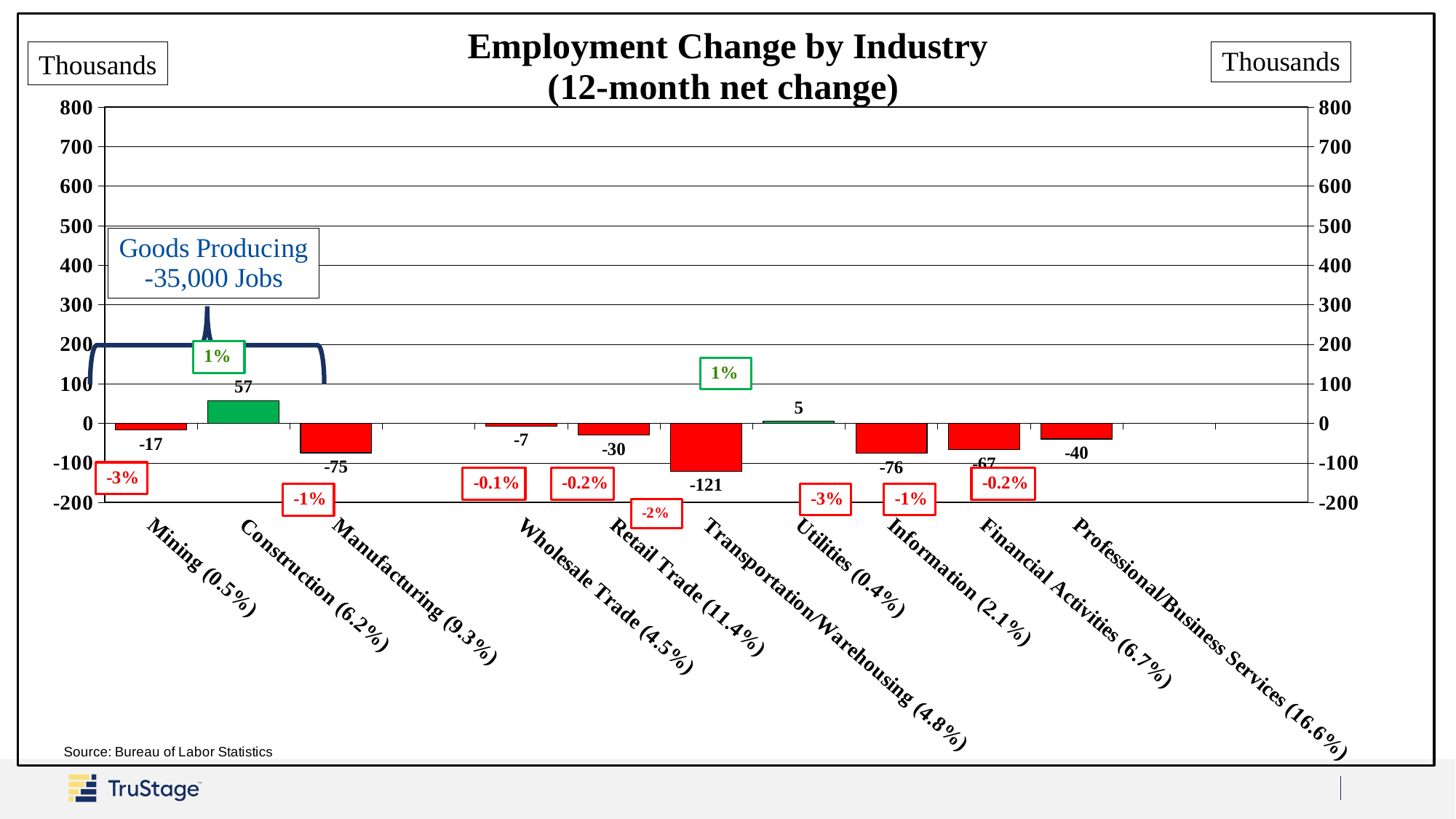
Which has a larger employment change, Utilities or Retail Trade? Utilities How many industries are plotted on the chart? 10 What kind of chart is shown on the slide? Bar chart Which industry has the lowest 12-month net employment change? Transportation/Warehousing What is the difference between the employment change for Construction and for Mining? 74 Is the value for Transportation/Warehousing greater or less than -100? less What unit is shown on the y axis of the chart? Thousands Which industry has the largest 12-month net employment change? Construction What is the 12-month net employment change for Financial Activities? -67 What is the 12-month net employment change for Transportation/Warehousing? -121 What is the 12-month net employment change for Construction? 57 According to the annotation, what is the total job change for Goods Producing industries? -35,000 Jobs